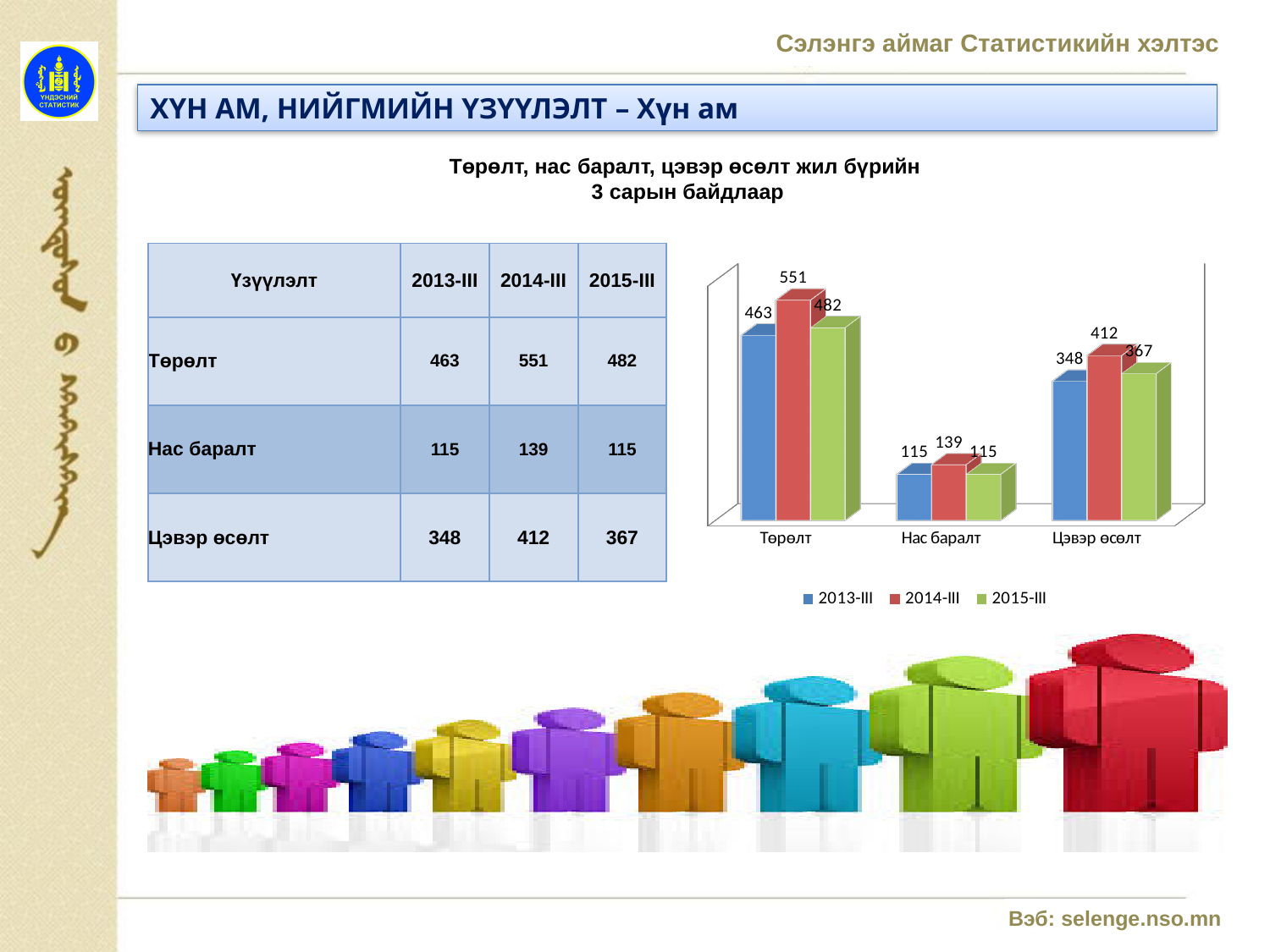
Which category has the lowest value in the 2015-III series? Нас баралт What is the value for Нас баралт in the 2013-III series? 115 Which category has the highest value in the 2014-III series? Төрөлт How many categories are shown on the x axis of the chart? 3 What is the difference between the 2014-III and 2015-III values for Цэвэр өсөлт? 45 Which is larger for Төрөлт: the 2013-III value or the 2015-III value? 2015-III What is the value for Төрөлт in the 2014-III series? 551 Which series is shown in red in the chart legend? 2014-III What is the value for Цэвэр өсөлт in the 2015-III series? 367 What type of chart is shown on the slide? bar chart How many series does the chart legend list? 3 What is the difference between the 2014-III and 2013-III values for Төрөлт? 88